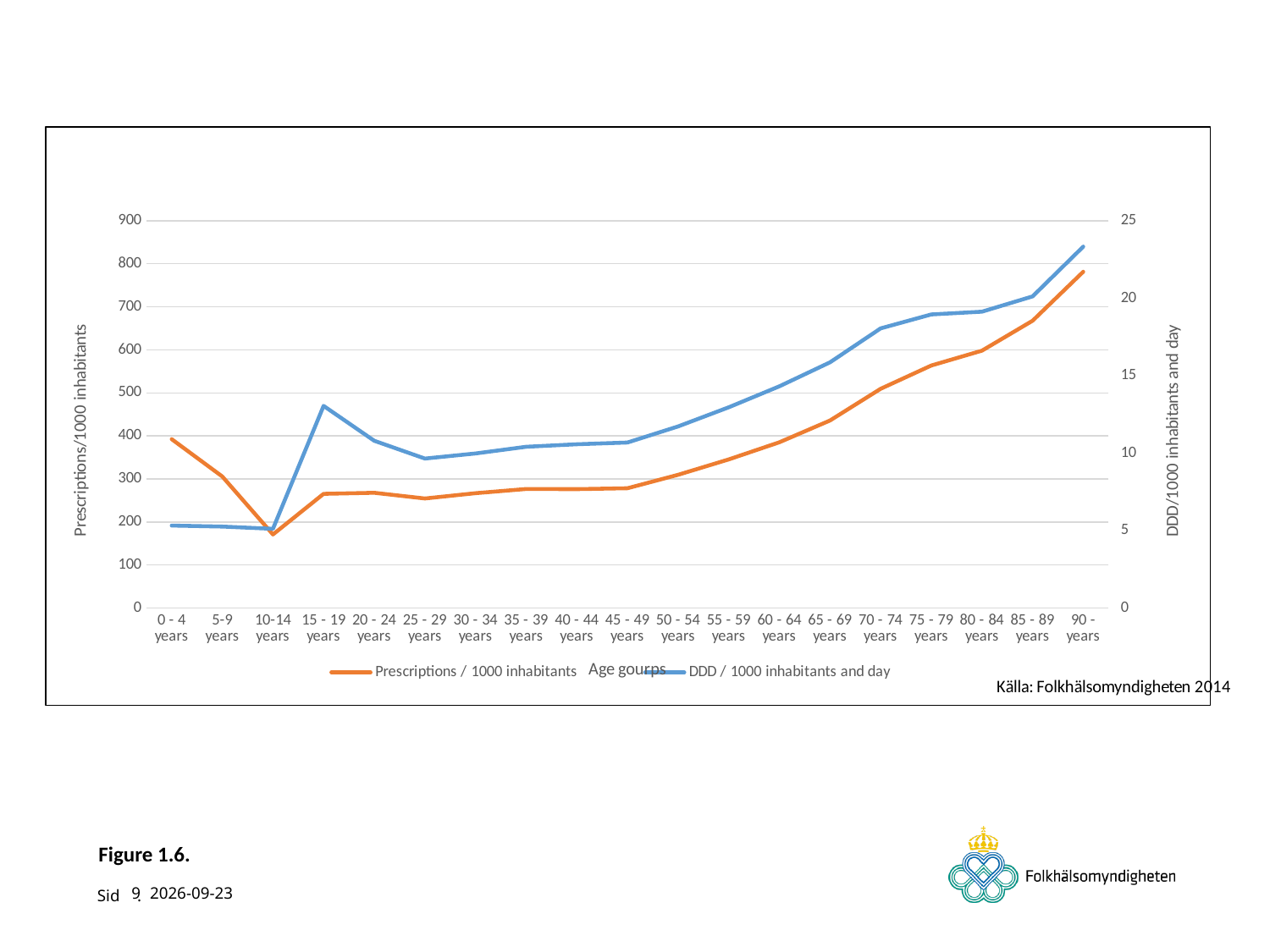
Is the value for DDD / 1000 inhabitants and day for 15 - 19 years greater or less than 10? greater Which age group has the lowest value for Prescriptions / 1000 inhabitants? 10-14 years What is the title of the right-hand vertical axis? DDD/1000 inhabitants and day How many series does the legend list? 2 Which age group has the highest value for Prescriptions / 1000 inhabitants? 90 - years Which age group has the highest value for DDD / 1000 inhabitants and day? 90 - years How many age groups are shown on the x axis? 19 Do the values for Prescriptions / 1000 inhabitants rise or fall from 15 - 19 years to 90 - years? rise Is the value for Prescriptions / 1000 inhabitants for 25 - 29 years greater or less than 300? less Is the value for Prescriptions / 1000 inhabitants for 90 - years greater or less than 700? greater What kind of chart is shown on the slide? line chart